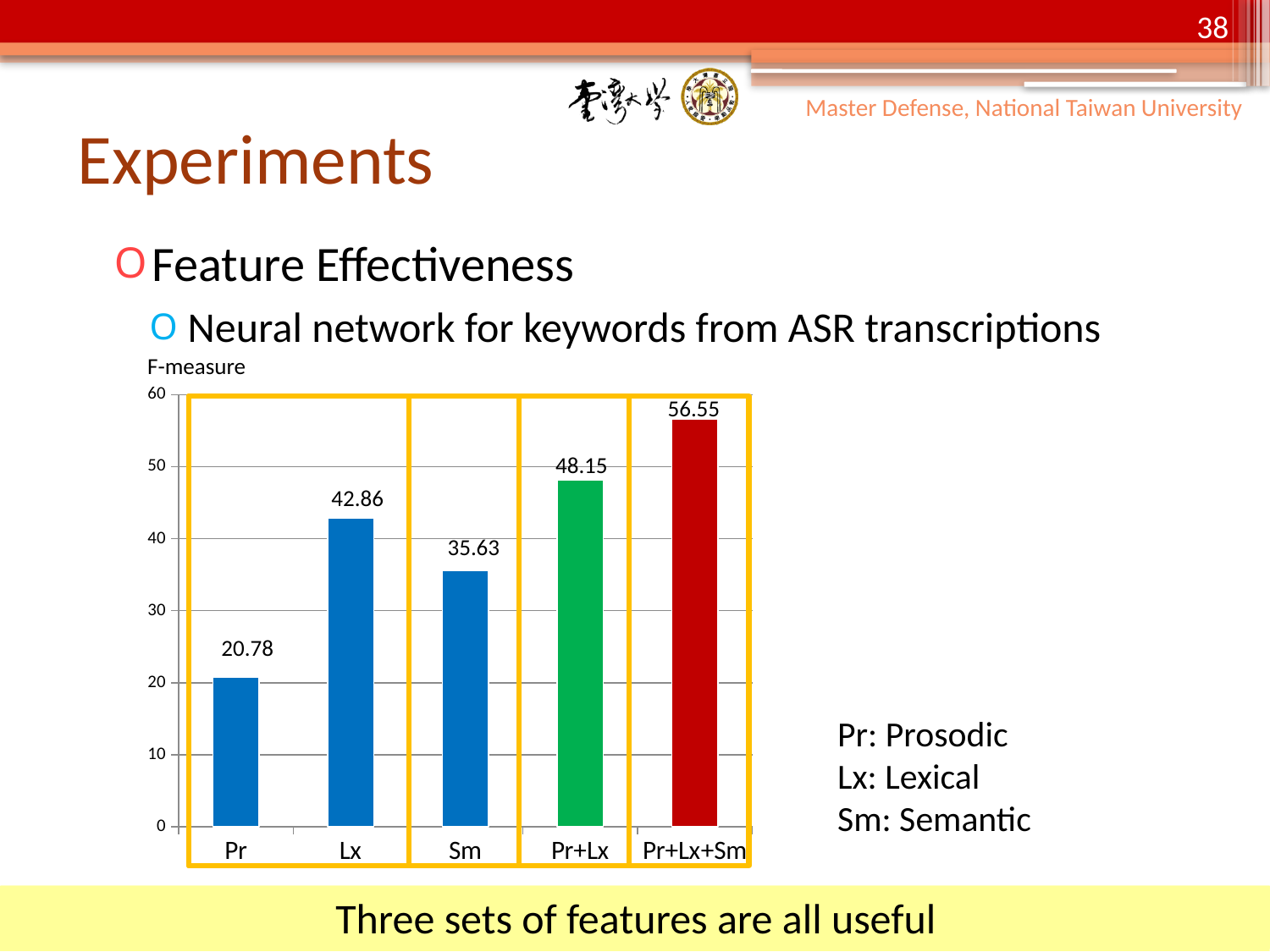
What does the label Sm stand for according to the slide? Semantic Is the F-measure for Pr+Lx greater or less than 50? less Which has a higher F-measure, Lx or Sm? Lx Which category has the lowest F-measure? Pr Which category has the highest F-measure? Pr+Lx+Sm What is the difference in F-measure between Pr+Lx and Lx? 5.29 What is the difference in F-measure between Pr+Lx+Sm and Pr+Lx? 8.40 What is the F-measure for Pr? 20.78 What is the F-measure for Sm? 35.63 What is the F-measure for Pr+Lx+Sm? 56.55 What kind of chart is shown on the slide? bar chart How many categories are shown on the x axis? 5